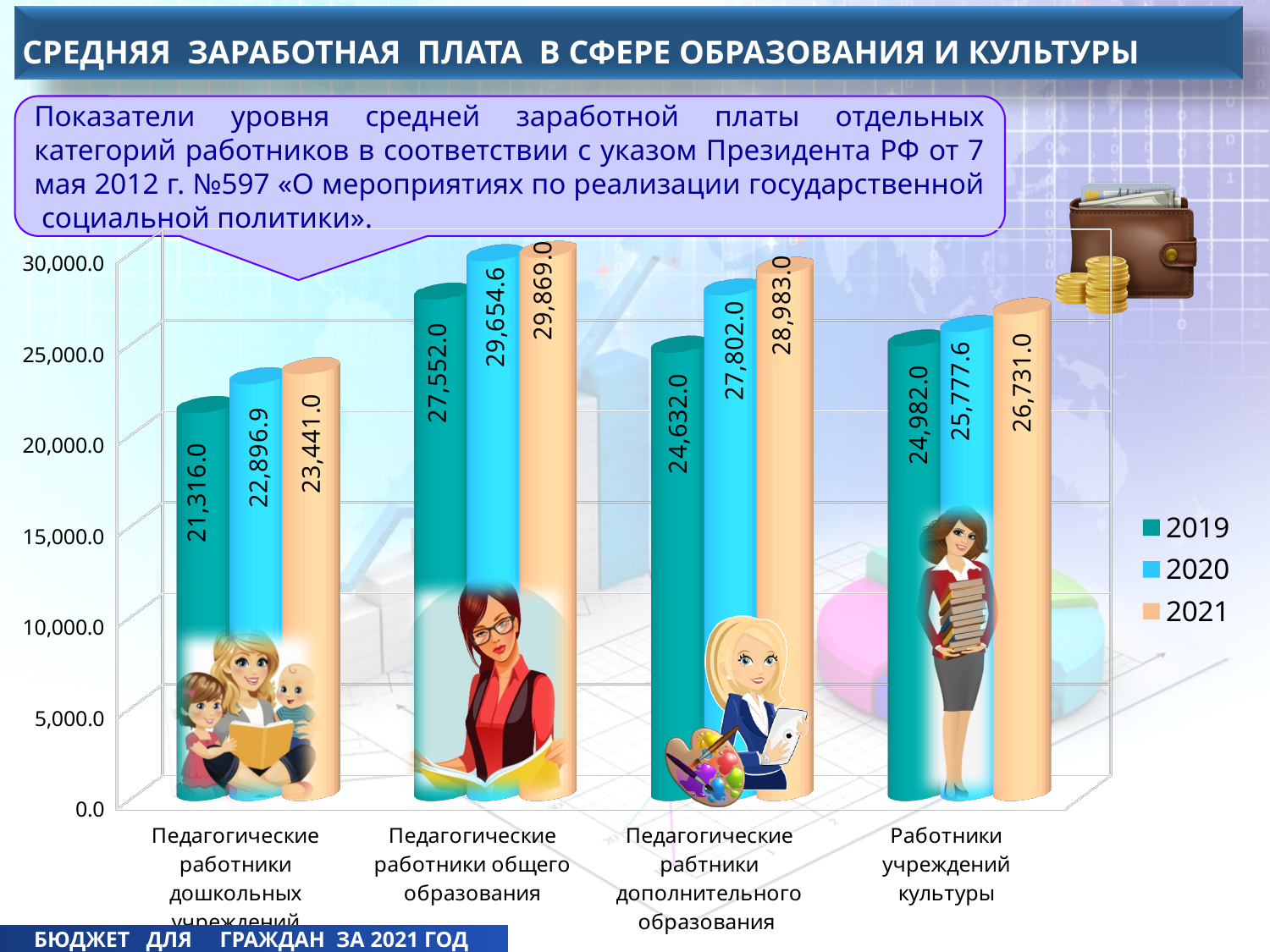
Is the 2019 value for Педагогические работники дополнительного образования greater or less than 25,000.0? less What is the 2020 value for Работники учреждений культуры? 25,777.6 Which category has the highest 2021 value? Педагогические работники общего образования What is the 2019 value for Педагогические работники дошкольных учреждений? 21,316.0 Which is larger: the 2021 value for Работники учреждений культуры or the 2021 value for Педагогические работники дополнительного образования? Педагогические работники дополнительного образования Which category has the lowest 2019 value? Педагогические работники дошкольных учреждений What is the 2020 value for Педагогические работники дополнительного образования? 27,802.0 What kind of chart is shown on the slide? bar chart How many categories are shown on the x axis? 4 What is the 2021 value for Педагогические работники общего образования? 29,869.0 How many series does the legend list? 3 What is the difference between the 2021 and 2019 values for Педагогические работники общего образования? 2,317.0